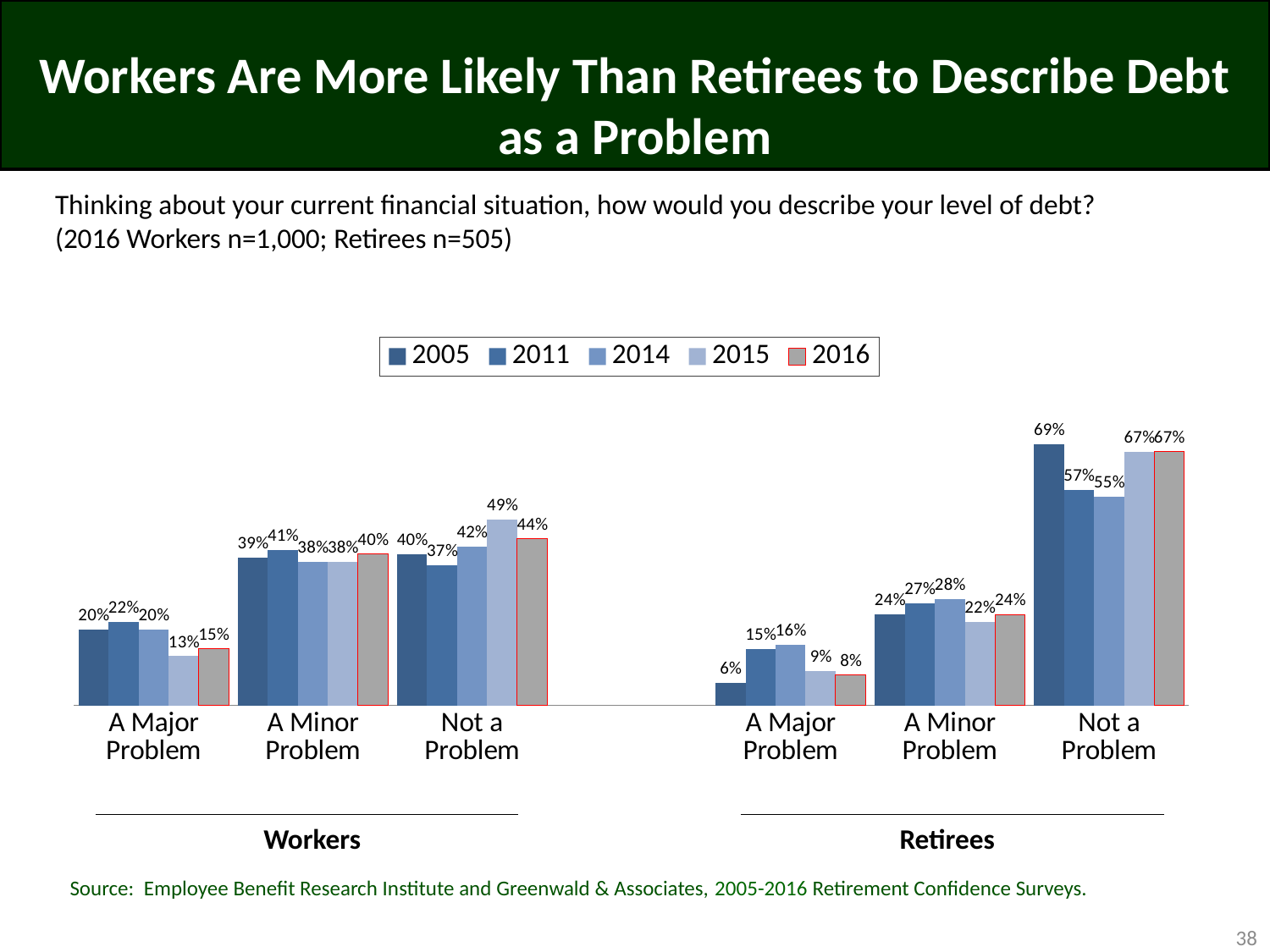
Among workers, in which year was the share saying debt is not a problem the highest? 2015 How many response categories are shown for each group (Workers and Retirees)? 3 What percentage of workers described debt as a minor problem in 2011? 41% What percentage of retirees said debt was not a problem in 2005? 69% Among retirees, in which year was the share describing debt as a major problem the lowest? 2005 In 2016, which group had a larger share saying debt is not a problem, workers or retirees? Retirees What percentage of retirees described debt as a major problem in 2014? 16% What type of chart is shown on the slide? Bar chart What percentage of workers described debt as a major problem in 2016? 15% Which year's bars are outlined in red in the chart? 2016 How many series does the legend list? 5 What is the difference between the 2016 percentages of workers and retirees who described debt as a major problem? 7 percentage points